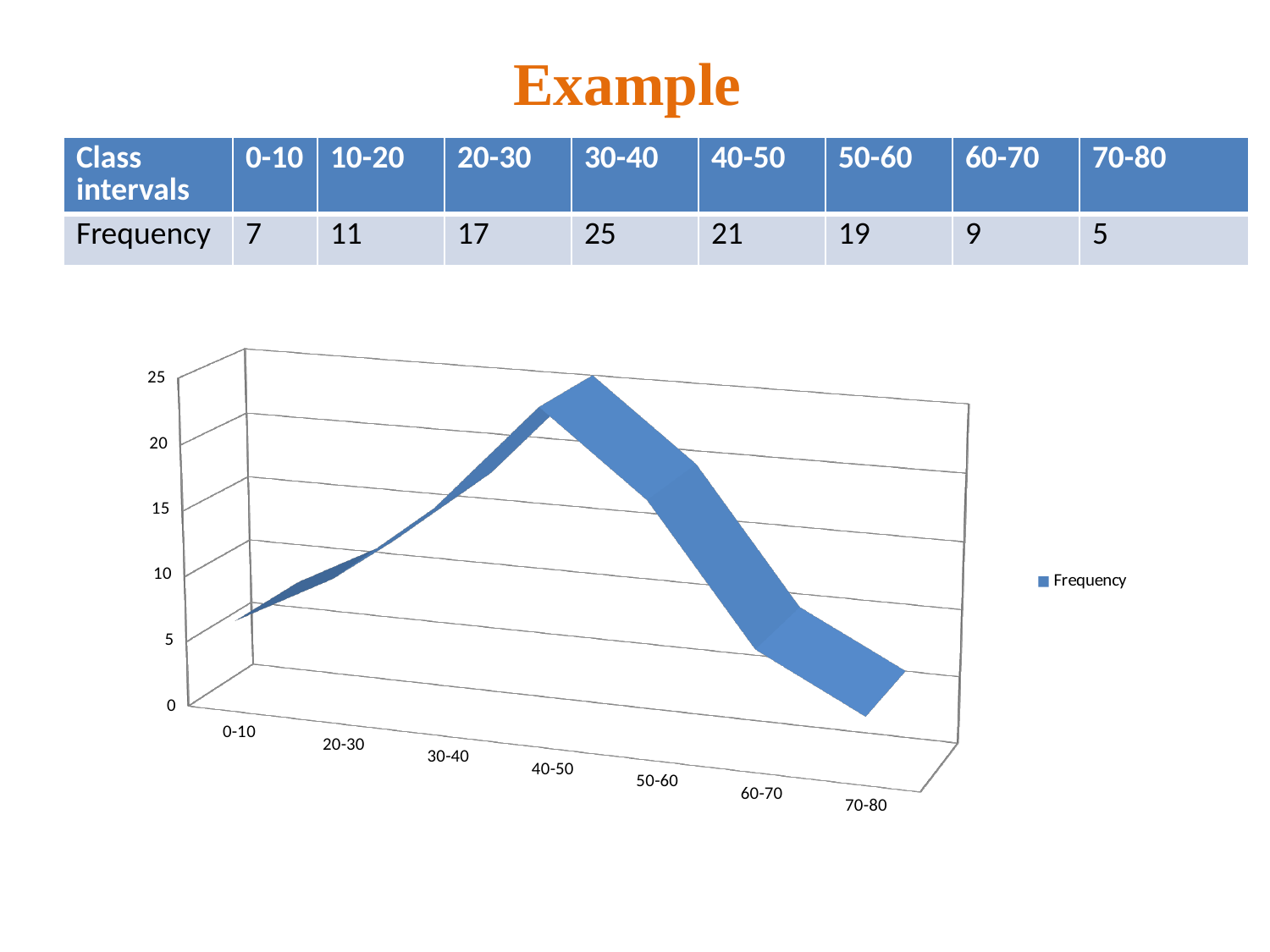
What type of chart is shown on the slide? 3D line chart How many series does the chart legend list? 1 What is the difference between the highest frequency (30-40) and the lowest frequency (70-80)? 20 Is the value for the class interval 40-50 greater or less than 20? greater What is the frequency for the class interval 50-60? 19 Which has a larger frequency, the class interval 20-30 or 60-70? 20-30 What is the frequency for the class interval 0-10? 7 Which class interval has the lowest frequency? 70-80